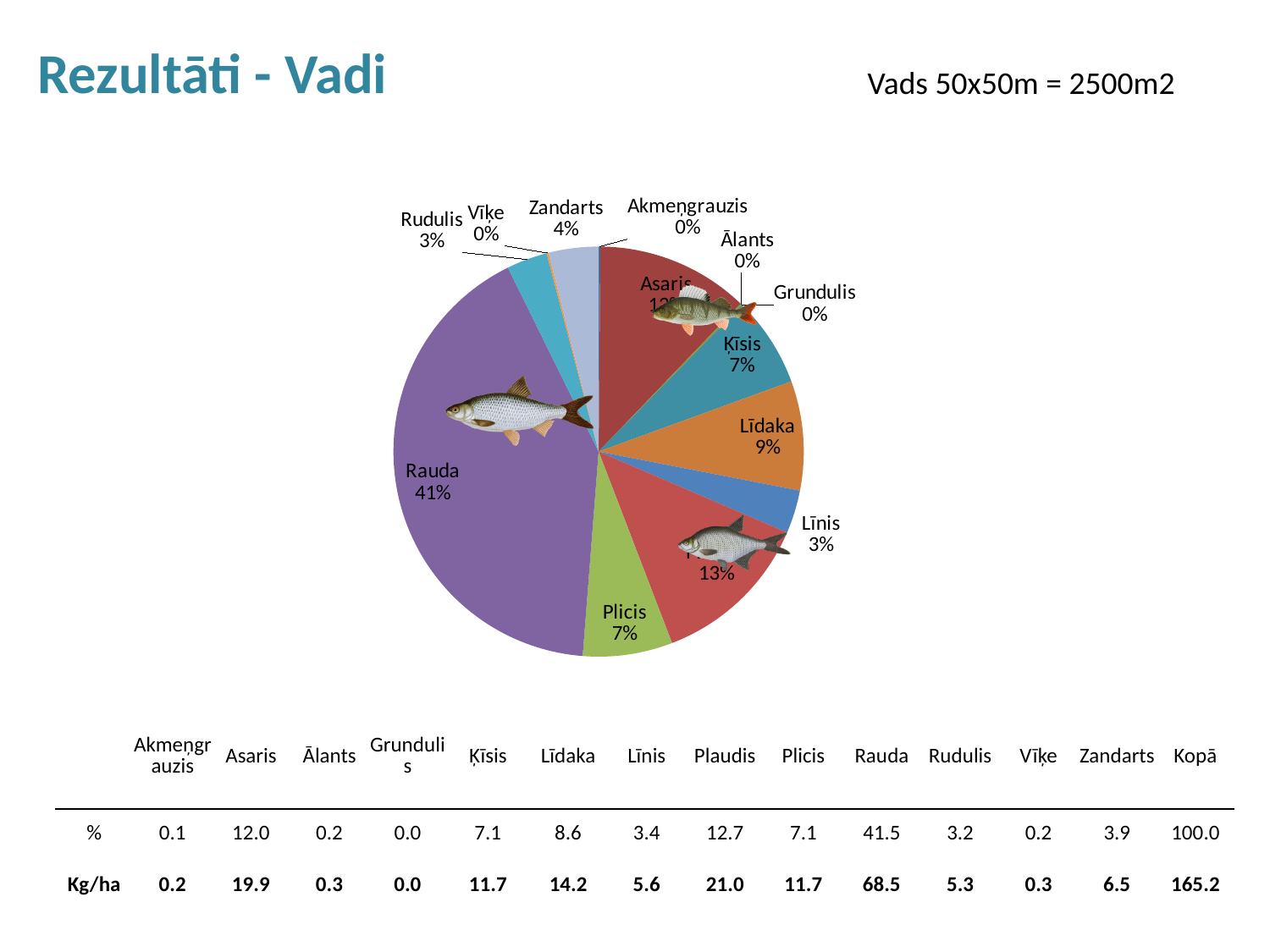
What is the value shown for Zandarts in the pie chart? 4% What kind of chart is shown on the slide? pie chart What is the title of the slide containing the pie chart? Rezultāti - Vadi How many categories are shown in the pie chart? 13 What share of the pie does Rauda account for? 41% What is the value shown for Plicis in the pie chart? 7% What is the value shown for Ķīsis in the pie chart? 7% Which category has the largest slice in the pie chart? Rauda Which has a larger share in the pie chart, Līdaka or Līnis? Līdaka What is the difference in percentage points between the Rauda slice and the Līdaka slice? 32 What is the value shown for Līdaka in the pie chart? 9% What is the value shown for Rudulis in the pie chart? 3%